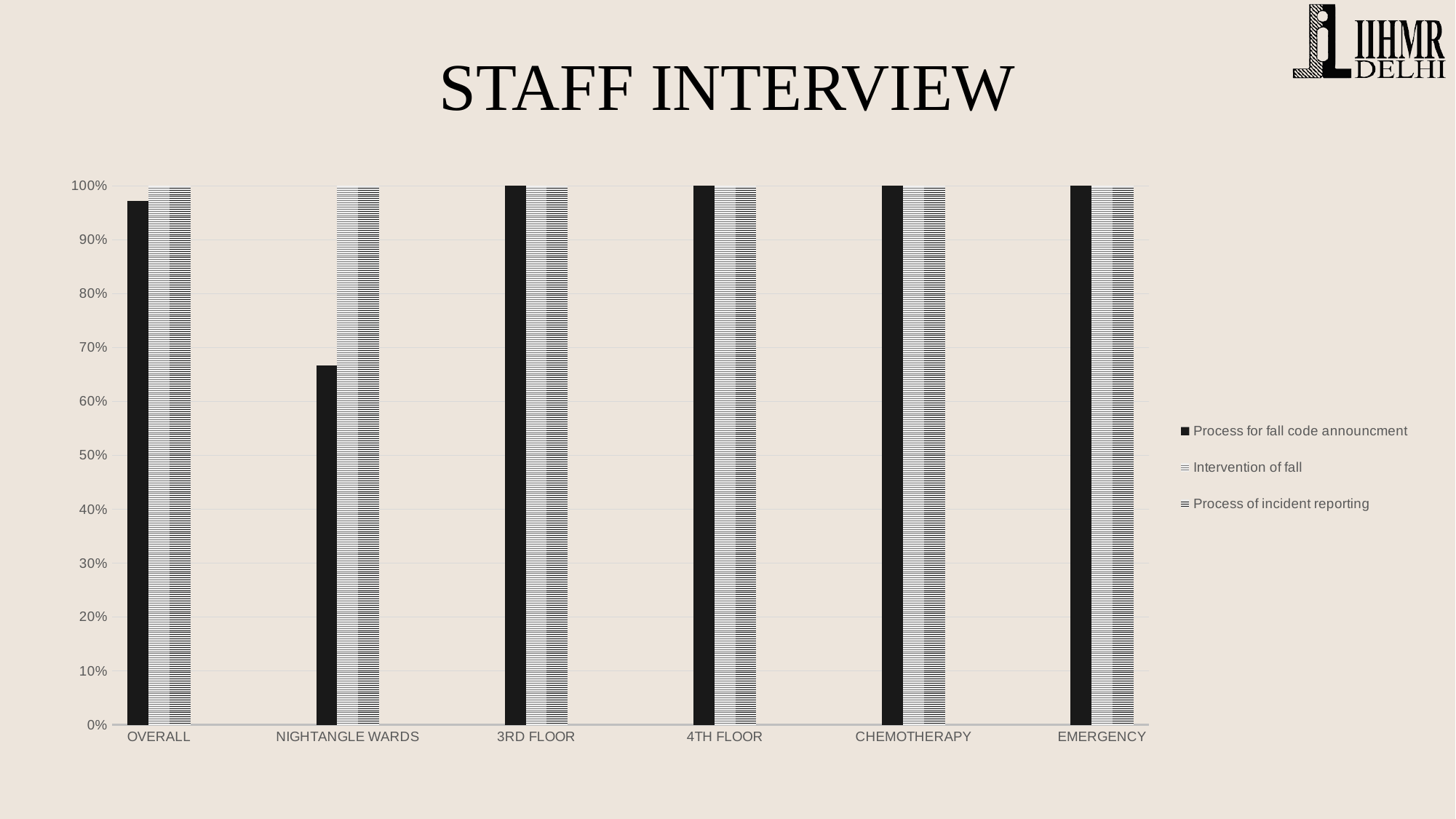
Is the 'Process for fall code announcment' value for OVERALL greater or less than 90%? greater How many series does the chart's legend list? 3 Which category has the lowest value for the 'Process for fall code announcment' series? NIGHTANGLE WARDS Is the 'Process for fall code announcment' value for NIGHTANGLE WARDS greater or less than 70%? less What is the 'Process for fall code announcment' value for 3RD FLOOR? 100% What is the 'Intervention of fall' value for EMERGENCY? 100% What kind of chart is shown on the slide? bar chart What is the title of the chart on the slide? STAFF INTERVIEW How many categories are shown along the x axis of the chart? 6 Which series is shown with solid black bars in the legend? Process for fall code announcment Is the 'Process for fall code announcment' value for NIGHTANGLE WARDS greater or less than 60%? greater For NIGHTANGLE WARDS, which is larger: 'Process for fall code announcment' or 'Intervention of fall'? Intervention of fall